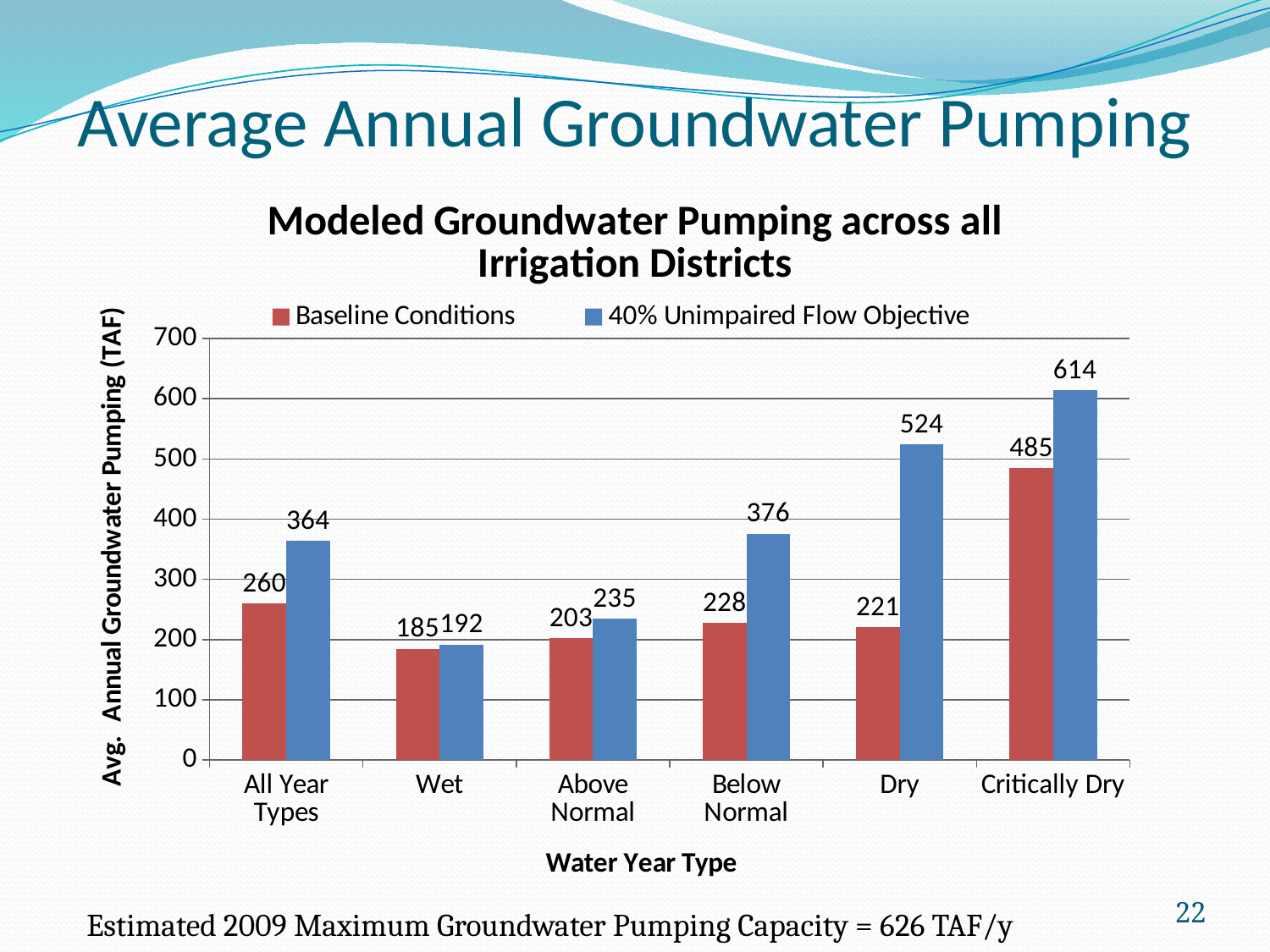
What is the label of the y axis? Avg. Annual Groundwater Pumping (TAF) What is the difference between the 40% Unimpaired Flow Objective and Baseline Conditions values for Below Normal? 148 Which water year type has the lowest Baseline Conditions value? Wet What kind of chart is shown on the slide? Bar chart What is the Baseline Conditions value for Critically Dry? 485 What is the 40% Unimpaired Flow Objective value for Dry? 524 What is the Baseline Conditions value for Wet? 185 Is the 40% Unimpaired Flow Objective value for Critically Dry greater or less than 600? greater Which water year type has the highest 40% Unimpaired Flow Objective value? Critically Dry How many series does the legend list? 2 How many water year type categories are shown on the x axis? 6 Which is larger for All Year Types: Baseline Conditions or 40% Unimpaired Flow Objective? 40% Unimpaired Flow Objective